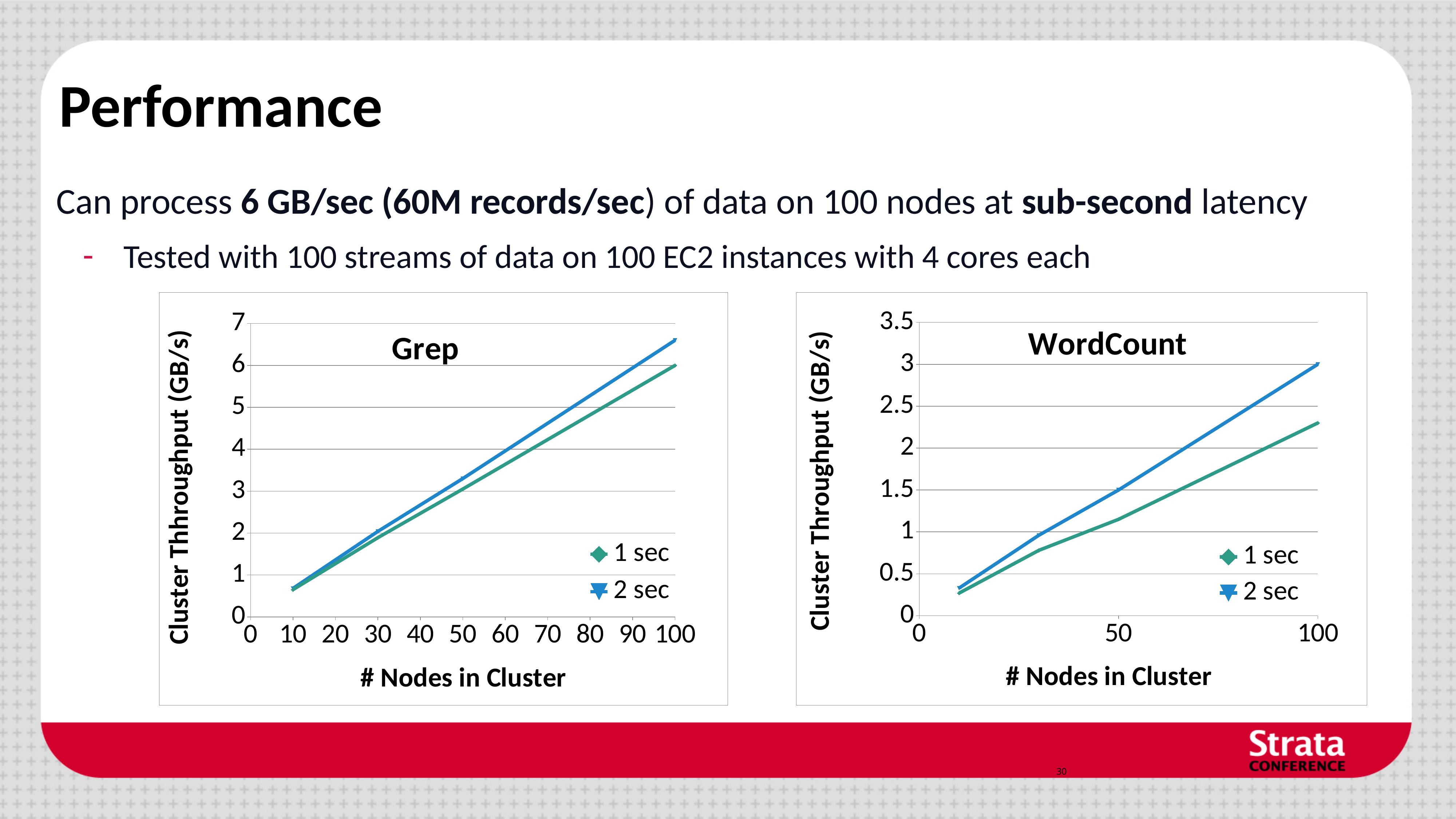
In the WordCount chart, is the 1 sec throughput at 100 nodes greater or less than 2.5 GB/s? less What kind of chart is the WordCount chart? line chart In the WordCount chart, does cluster throughput rise or fall as the number of nodes increases? rise In the Grep chart, does cluster throughput rise or fall as the number of nodes increases? rise In the Grep chart, is the 2 sec throughput at 100 nodes greater or less than 6 GB/s? greater How many series does the legend of the WordCount chart list? 2 In the Grep chart, which series has the higher throughput at 100 nodes, 1 sec or 2 sec? 2 sec What kind of chart is the Grep chart? line chart What is the x-axis label of the Grep chart? # Nodes in Cluster In the WordCount chart, is the 2 sec throughput at 50 nodes greater or less than 2 GB/s? less In the WordCount chart, which series has the higher throughput at 100 nodes, 1 sec or 2 sec? 2 sec How many series does the legend of the Grep chart list? 2